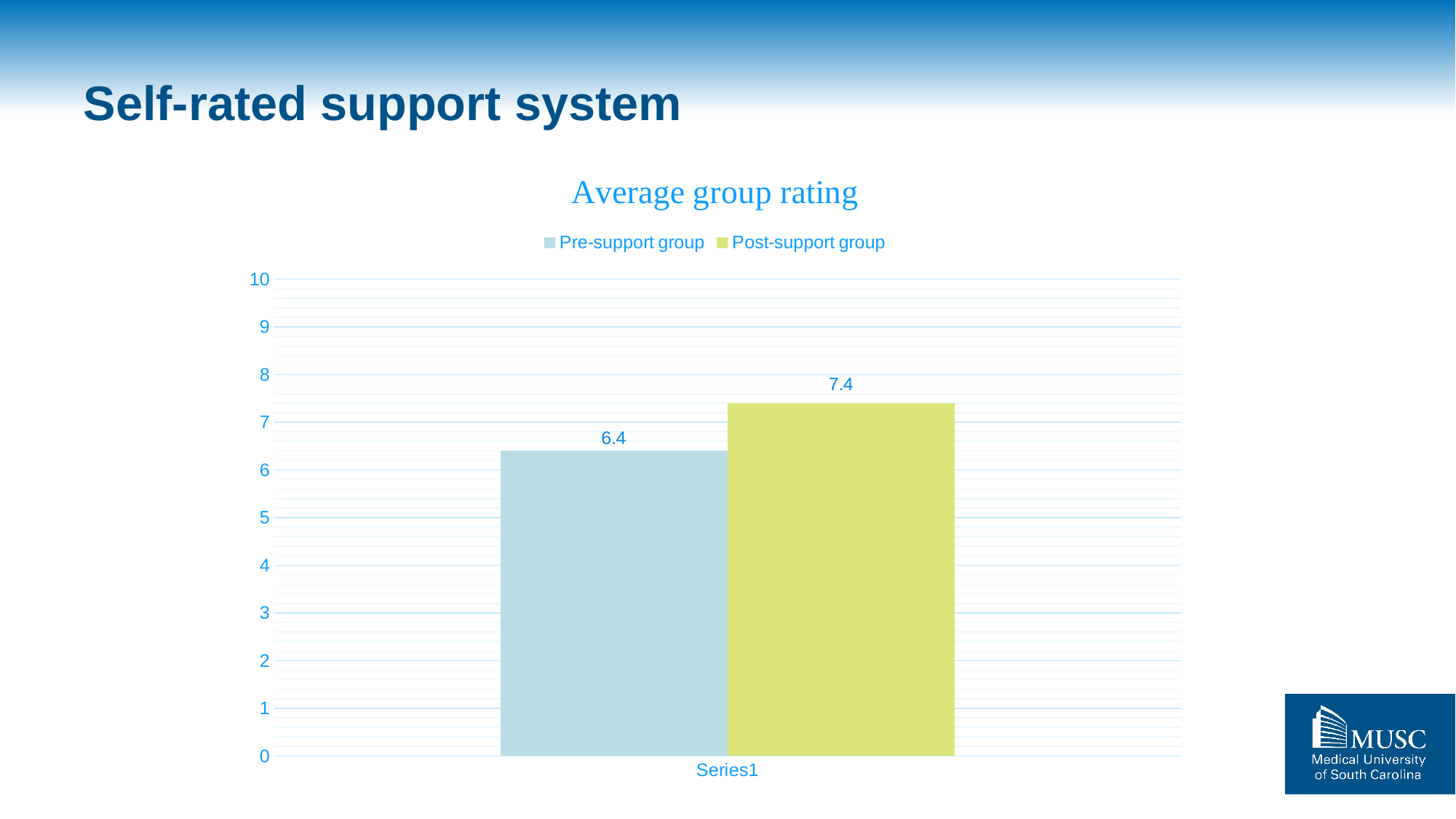
What is the value for the Pre-support group? 6.4 What kind of chart is shown on the slide? bar chart How many series does the legend list? 2 What is the maximum value shown on the vertical axis? 10 Which series has the lower value? Pre-support group Is the value for the Post-support group greater or less than 7? greater Which series has the higher value, Pre-support group or Post-support group? Post-support group What is the difference between the Post-support group and Pre-support group values? 1 Is the value for the Pre-support group greater or less than 7? less What is the category label shown on the x axis? Series1 What is the title of the chart? Average group rating What is the value for the Post-support group? 7.4